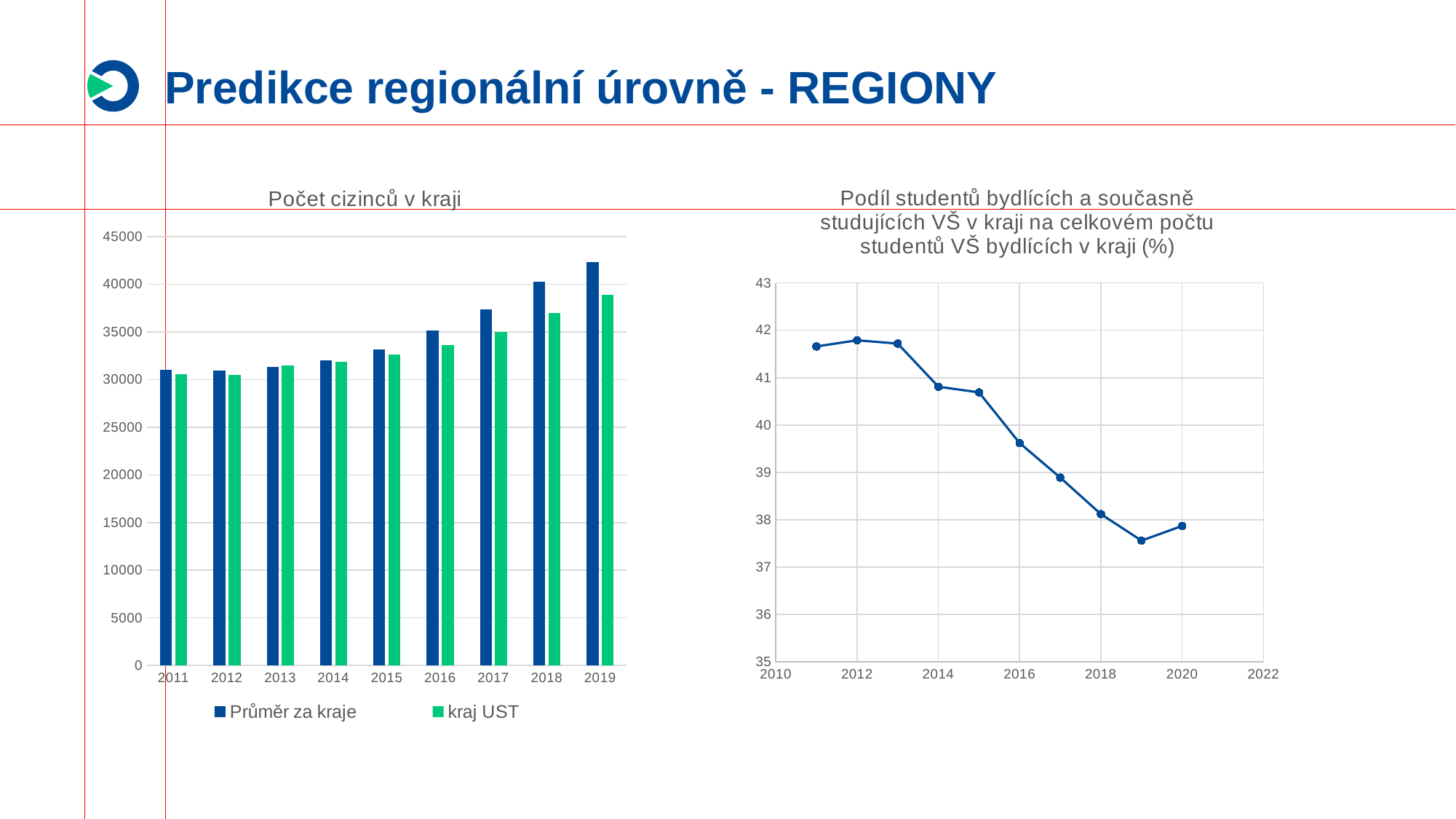
In the left chart 'Počet cizinců v kraji', how many series does the legend list? 2 In the left chart 'Počet cizinců v kraji', do the values for 'kraj UST' generally rise or fall from 2011 to 2019? rise In the right line chart, is the value for 2016 greater or less than 40? less In the left chart 'Počet cizinců v kraji', is the value for 'Průměr za kraje' in 2014 greater or less than 35000? less In the right line chart, do the values generally rise or fall from 2011 to 2019? fall In the left chart 'Počet cizinců v kraji', which is larger in 2018: 'Průměr za kraje' or 'kraj UST'? Průměr za kraje What kind of chart is the right chart about the share of students living and studying in the region? line chart In the left chart 'Počet cizinců v kraji', is the value for 'kraj UST' in 2019 greater or less than 35000? greater In the right line chart, which year has the lowest value? 2019 In the left chart 'Počet cizinců v kraji', which year has the highest value for 'Průměr za kraje'? 2019 In the left chart 'Počet cizinců v kraji', how many years are shown on the x axis? 9 What kind of chart is the left chart titled 'Počet cizinců v kraji'? bar chart